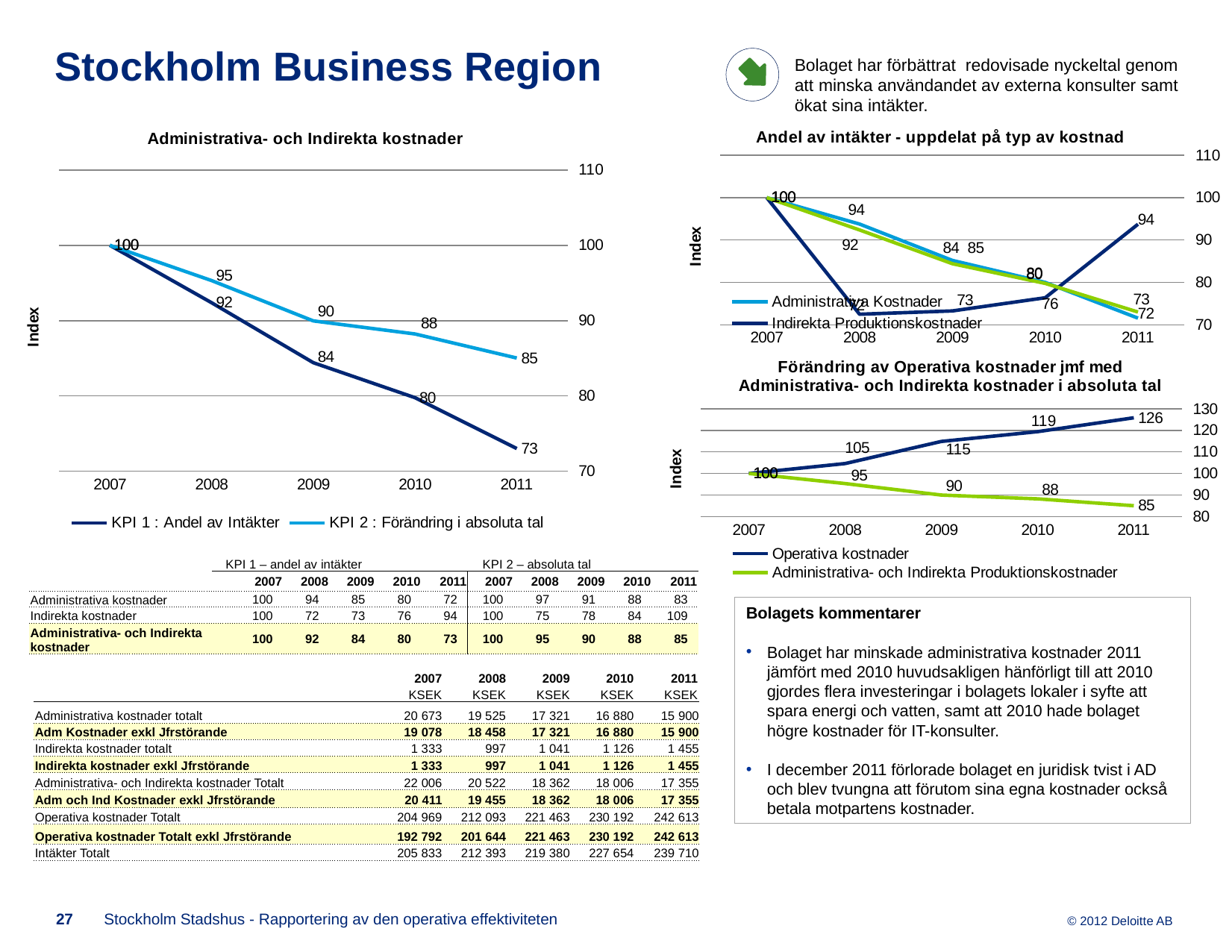
What kind of chart is 'Administrativa- och Indirekta kostnader'? line chart In the chart 'Andel av intäkter - uppdelat på typ av kostnad', what is the value of Indirekta Produktionskostnader in 2011? 94 How many years are shown on the x axis of the chart 'Förändring av Operativa kostnader jmf med Administrativa- och Indirekta kostnader i absoluta tal'? 5 In the chart 'Administrativa- och Indirekta kostnader', does KPI 1 : Andel av Intäkter rise or fall from 2007 to 2011? fall In the chart 'Förändring av Operativa kostnader jmf med Administrativa- och Indirekta kostnader i absoluta tal', what is the value of Operativa kostnader in 2011? 126 How many series does the legend of the chart 'Administrativa- och Indirekta kostnader' list? 2 In the chart 'Administrativa- och Indirekta kostnader', what is the difference between KPI 2 and KPI 1 in 2011? 12 In the chart 'Administrativa- och Indirekta kostnader', what is the value of KPI 2 : Förändring i absoluta tal in 2009? 90 In the chart 'Förändring av Operativa kostnader jmf med Administrativa- och Indirekta kostnader i absoluta tal', in which year is Operativa kostnader highest? 2011 In the chart 'Förändring av Operativa kostnader jmf med Administrativa- och Indirekta kostnader i absoluta tal', what is the difference between Operativa kostnader and Administrativa- och Indirekta Produktionskostnader in 2010? 31 In the chart 'Administrativa- och Indirekta kostnader', what is the value of KPI 1 : Andel av Intäkter in 2011? 73 In the chart 'Andel av intäkter - uppdelat på typ av kostnad', what is the value of Administrativa Kostnader in 2011? 72